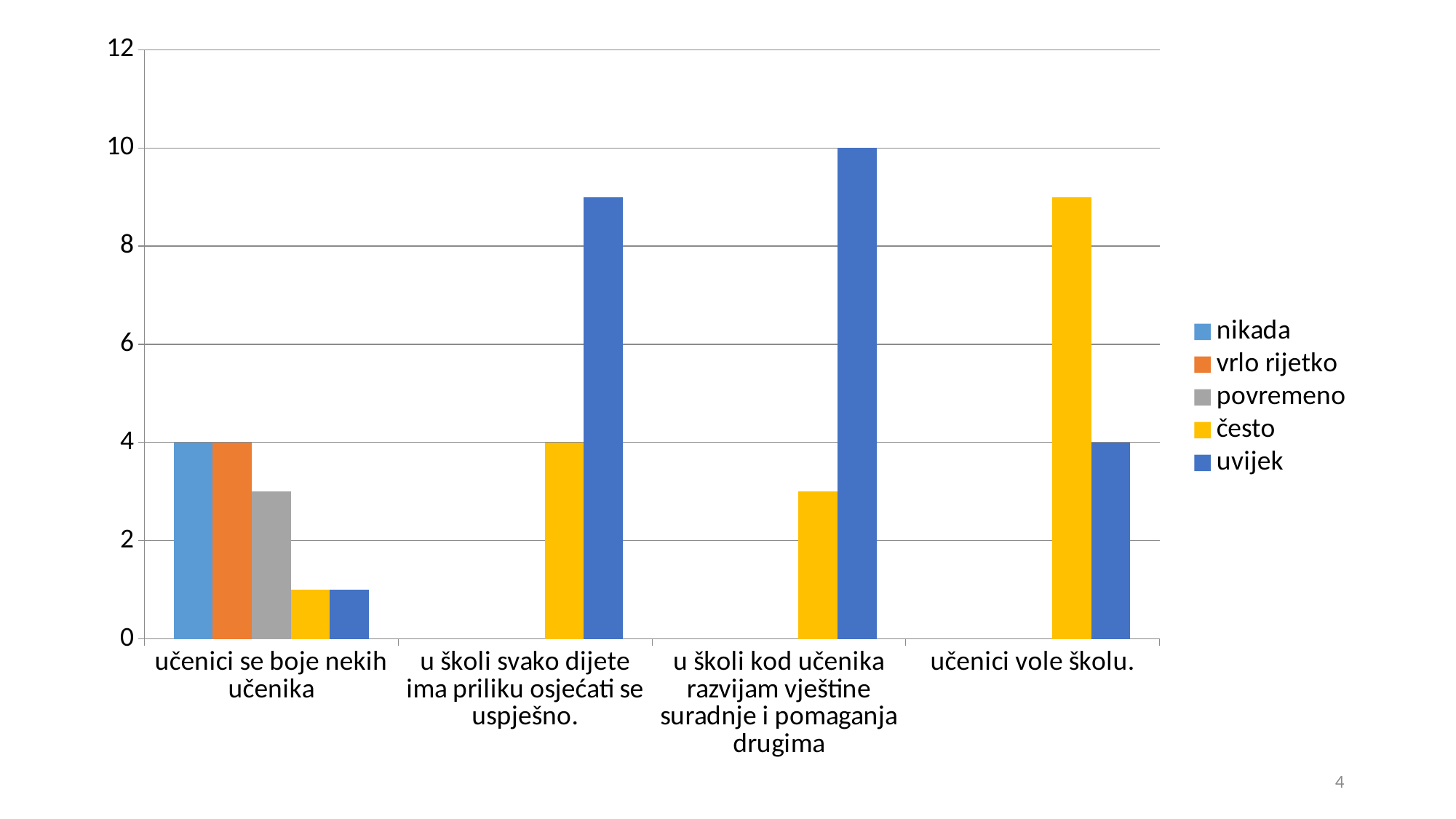
Is the value of 'uvijek' for 'u školi svako dijete ima priliku osjećati se uspješno.' greater or less than 8? greater How many series does the legend list? 5 How many categories are shown on the x axis? 4 What is the difference between the 'uvijek' value for 'u školi kod učenika razvijam vještine suradnje i pomaganja drugima' and the 'uvijek' value for 'učenici vole školu.'? 6 What is the value of 'uvijek' for 'učenici vole školu.'? 4 Which category has the highest 'uvijek' value? u školi kod učenika razvijam vještine suradnje i pomaganja drugima For 'u školi svako dijete ima priliku osjećati se uspješno.', which is larger: 'često' or 'uvijek'? uvijek What is the value of 'nikada' for 'učenici se boje nekih učenika'? 4 What kind of chart is shown on the slide? bar chart What is the value of 'uvijek' for 'u školi kod učenika razvijam vještine suradnje i pomaganja drugima'? 10 What is the value of 'često' for 'u školi svako dijete ima priliku osjećati se uspješno.'? 4 Is the value of 'često' for 'učenici vole školu.' greater or less than 8? greater